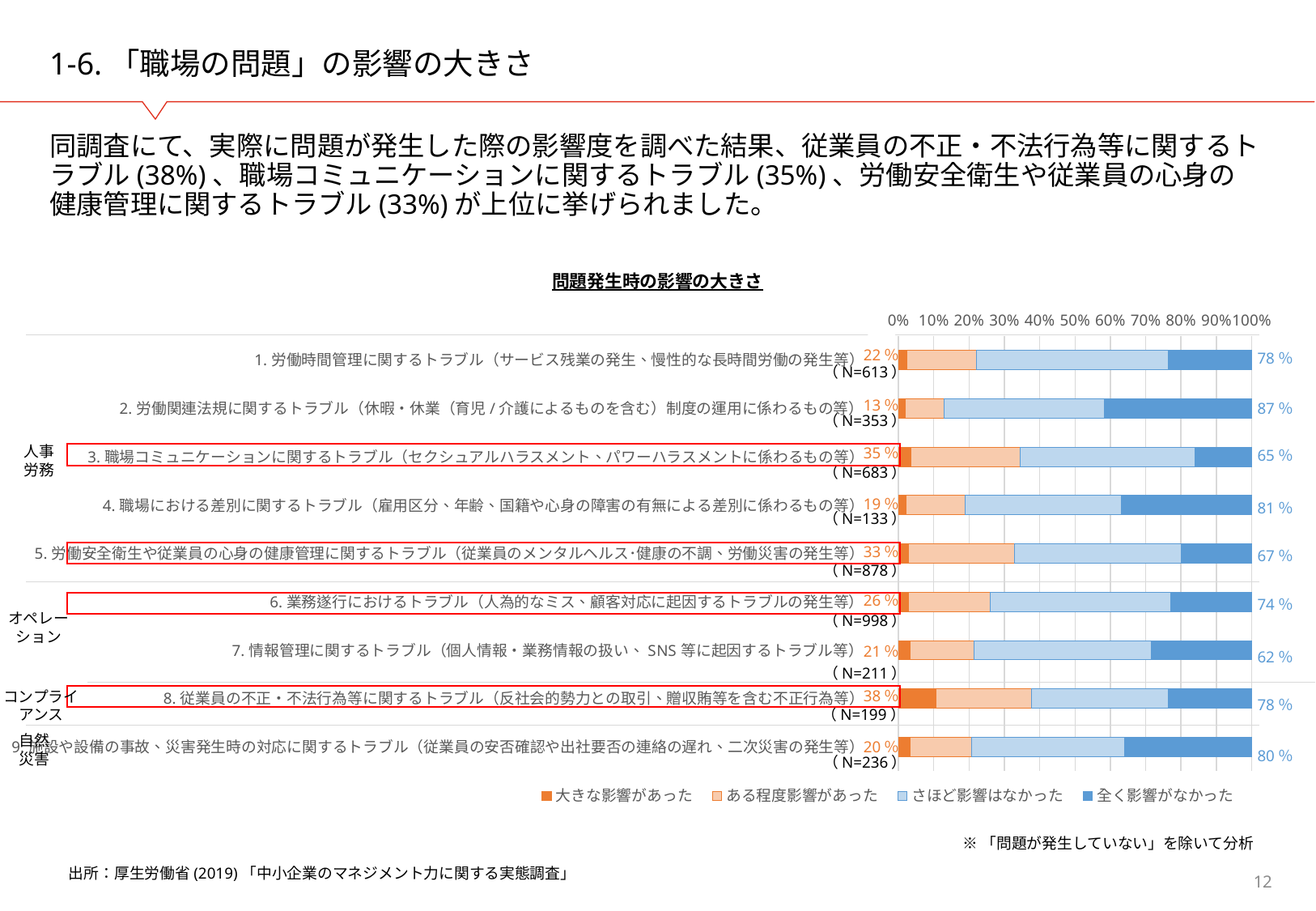
What kind of chart is shown on the slide? Stacked bar chart What is the title of the chart? 問題発生時の影響の大きさ What is the orange percentage label (share reporting an impact) for category 8, 従業員の不正・不法行為等に関するトラブル? 38 % What is the sample size (N) shown for category 6, 業務遂行におけるトラブル? N=998 Which has a larger orange percentage label: category 6 (業務遂行におけるトラブル) or category 9 (施設や設備の事故、災害発生時の対応に関するトラブル)? Category 6 (26 %) How many trouble categories are plotted in the chart? 9 What is the difference between the orange percentage labels of category 3 (職場コミュニケーションに関するトラブル) and category 5 (労働安全衛生や従業員の心身の健康管理に関するトラブル)? 2 percentage points What is the first legend entry (the dark orange series) in the chart? 大きな影響があった Which category has the lowest orange percentage label (share reporting an impact)? 2. 労働関連法規に関するトラブル (13 %) What is the blue percentage label (share reporting no impact) for category 2, 労働関連法規に関するトラブル? 87 % How many series does the chart legend list? 4 Which category has the highest orange percentage label (share reporting an impact)? 8. 従業員の不正・不法行為等に関するトラブル (38 %)